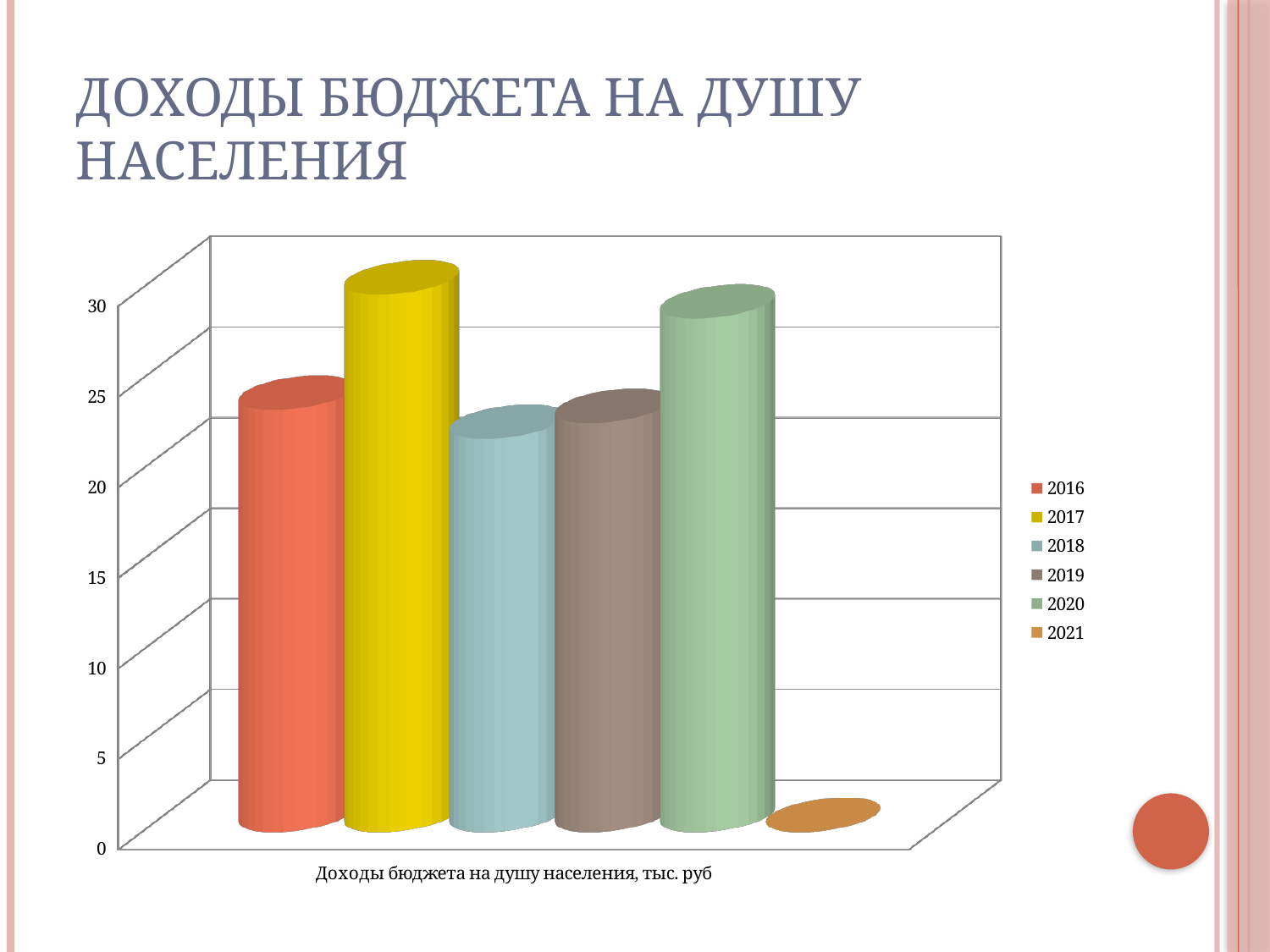
What is the category label shown under the chart? Доходы бюджета на душу населения, тыс. руб What kind of chart is shown on the slide? bar chart Is the value for 2020 greater or less than 25? greater Which year has the highest value in the chart? 2017 Which is larger, the value for 2017 or the value for 2018? 2017 Which year has the lowest value in the chart? 2021 Is the value for 2018 greater or less than 25? less How many series does the legend list? 6 Which is larger, the value for 2020 or the value for 2019? 2020 Is the value for 2021 greater or less than 5? less What is the title of the slide? ДОХОДЫ БЮДЖЕТА НА ДУШУ НАСЕЛЕНИЯ